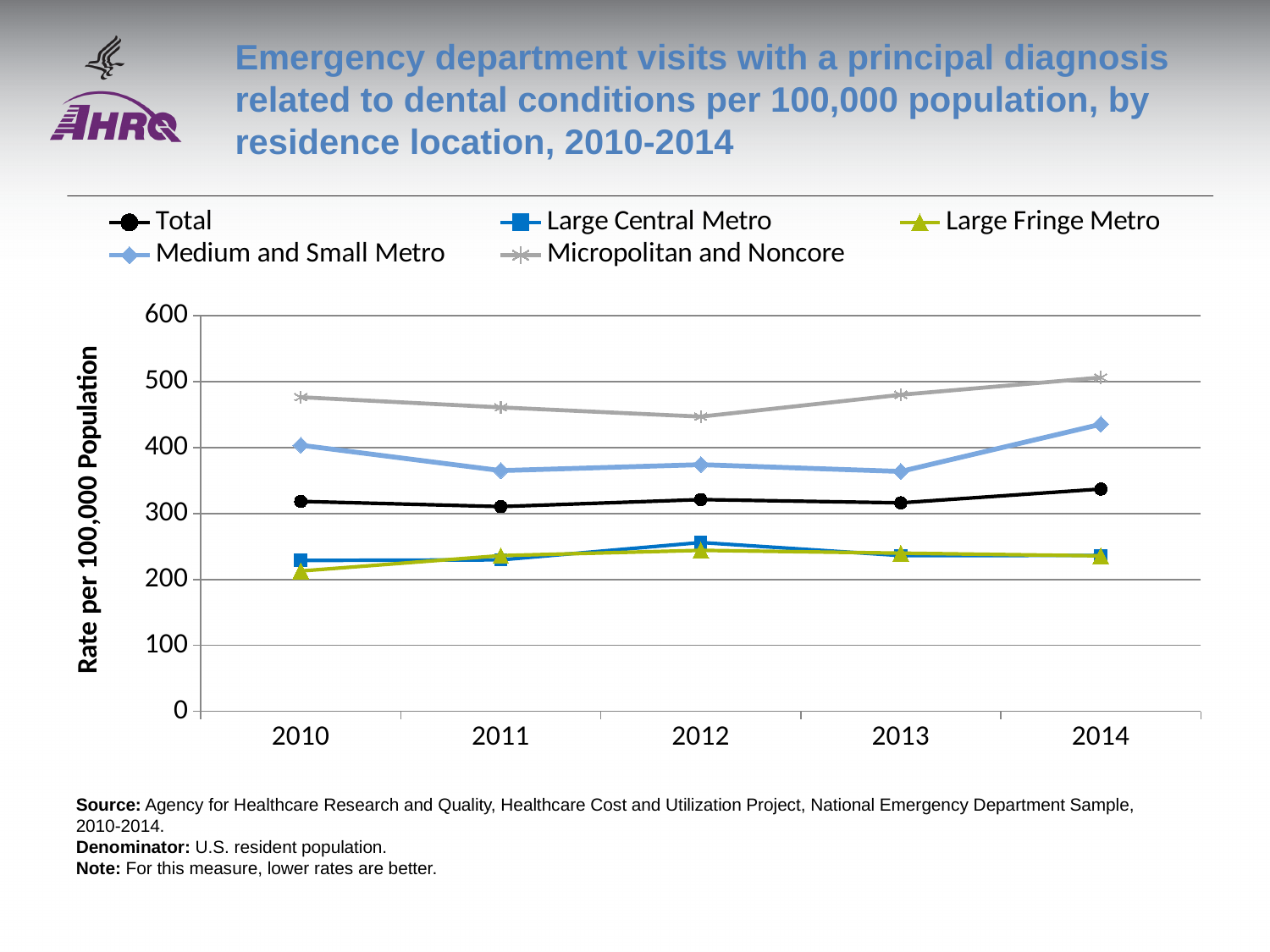
What is the label on the y axis? Rate per 100,000 Population Is the value for Large Fringe Metro in 2010 greater or less than 300? less Is the value for Micropolitan and Noncore in 2012 greater or less than 400? greater What kind of chart is shown on the slide? Line chart In 2013, which is larger: the rate for Medium and Small Metro or the rate for Total? Medium and Small Metro In which year is the Total rate highest? 2014 Which residence location has the lowest rate in 2010? Large Fringe Metro Does the Micropolitan and Noncore rate rise or fall from 2012 to 2014? Rise Which residence location has the highest rate in 2014? Micropolitan and Noncore How many series does the legend list? 5 How many years are plotted along the x axis? 5 Is the value for Medium and Small Metro in 2014 greater or less than 400? greater